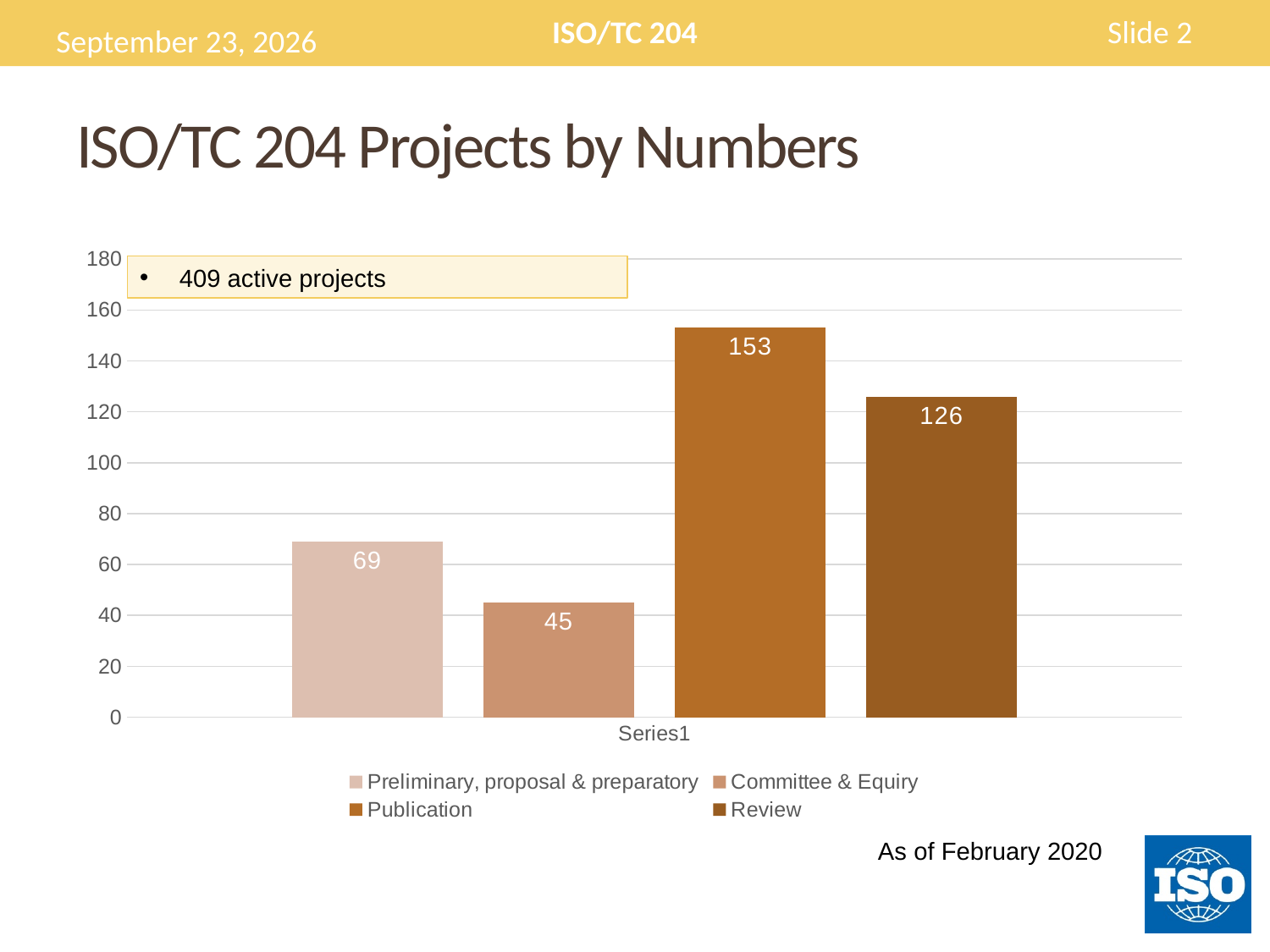
How many series does the legend list? 4 What is the total of the four plotted values? 393 What kind of chart is shown on the slide? Bar chart What is the value for Committee & Equiry? 45 Which series has the lowest value? Committee & Equiry Which is larger, the value for Preliminary, proposal & preparatory or the value for Committee & Equiry? Preliminary, proposal & preparatory What is the label shown on the x axis beneath the bars? Series1 What is the value for Preliminary, proposal & preparatory? 69 What is the value for Publication? 153 What is the difference between the values for Publication and Review? 27 What is the value for Review? 126 Which series has the highest value? Publication